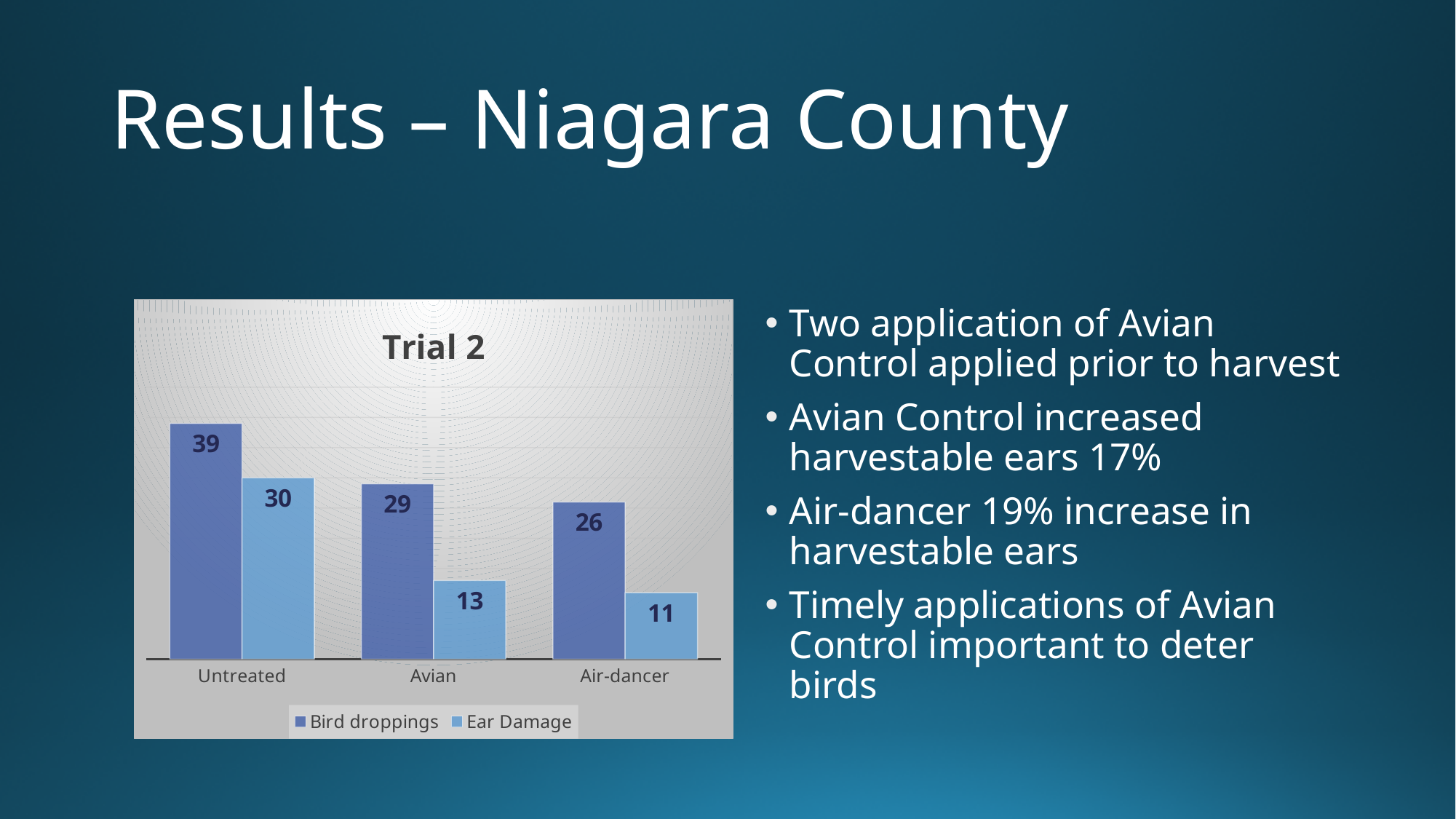
How many categories are shown on the x axis? 3 What is the difference between the Ear Damage values for Untreated and Air-dancer? 19 Which category has the highest Bird droppings value? Untreated What is the Bird droppings value for Untreated? 39 How many series does the legend list? 2 What is the Ear Damage value for Air-dancer? 11 Which is larger, the Bird droppings value for Avian or for Air-dancer? Avian Which category has the lowest Ear Damage value? Air-dancer What is the title of the chart? Trial 2 What is the difference between the Bird droppings values for Untreated and Avian? 10 What kind of chart is shown? Bar chart What is the Ear Damage value for Avian? 13